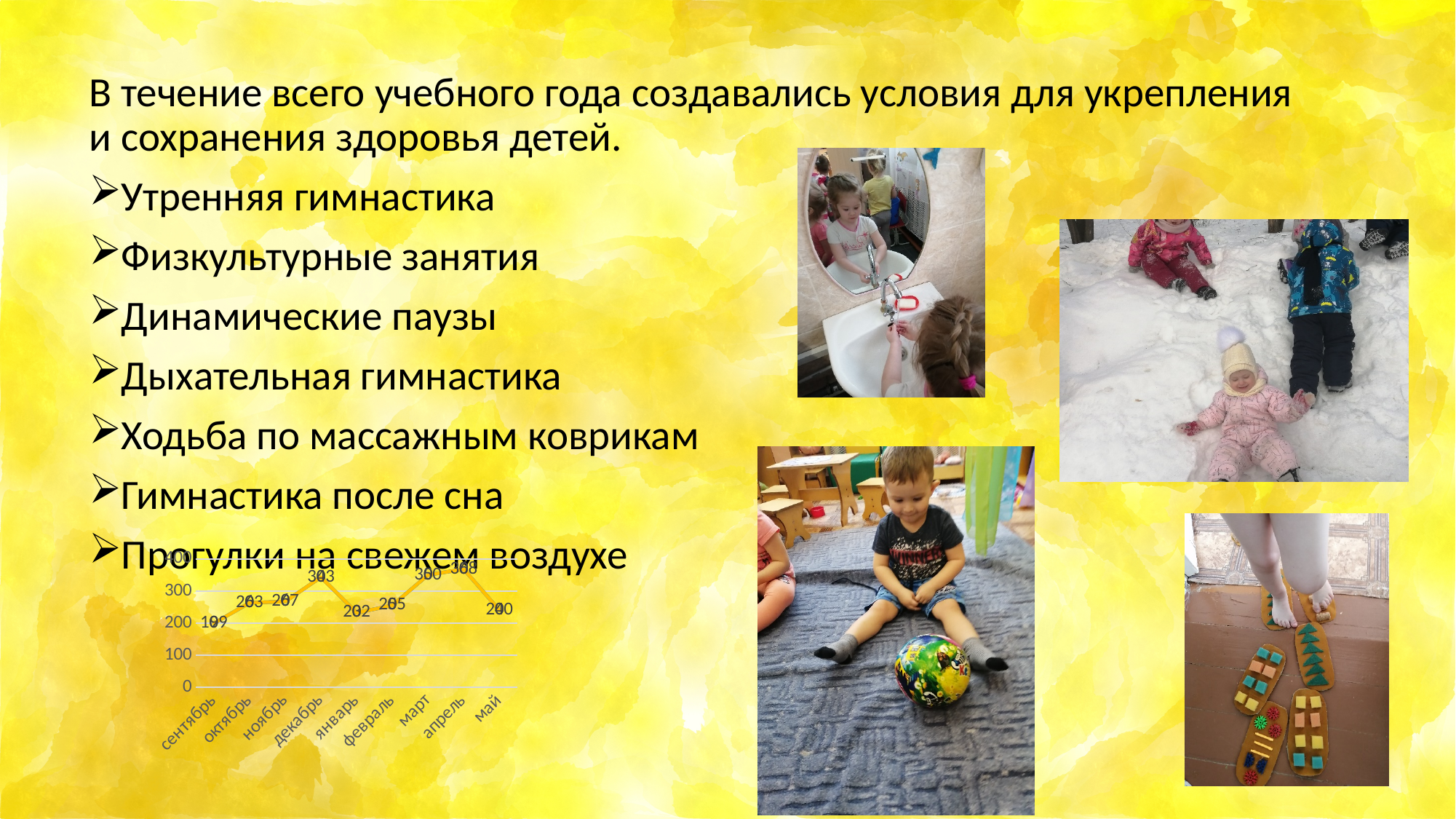
Which month has the highest value in the chart? апрель Which is larger in the chart, the value for декабрь or the value for январь? декабрь What is the value for февраль in the chart? 255 Is the value for март greater or less than 300? greater Do the values rise or fall from декабрь to январь in the chart? fall What is the value for январь in the chart? 232 What is the value for март in the chart? 350 What kind of chart is shown at the bottom left of the slide? line chart What is the difference between the values for декабрь and январь in the chart? 111 How many months are shown on the x axis of the chart? 9 What is the value for май in the chart? 240 What is the value for декабрь in the chart? 343